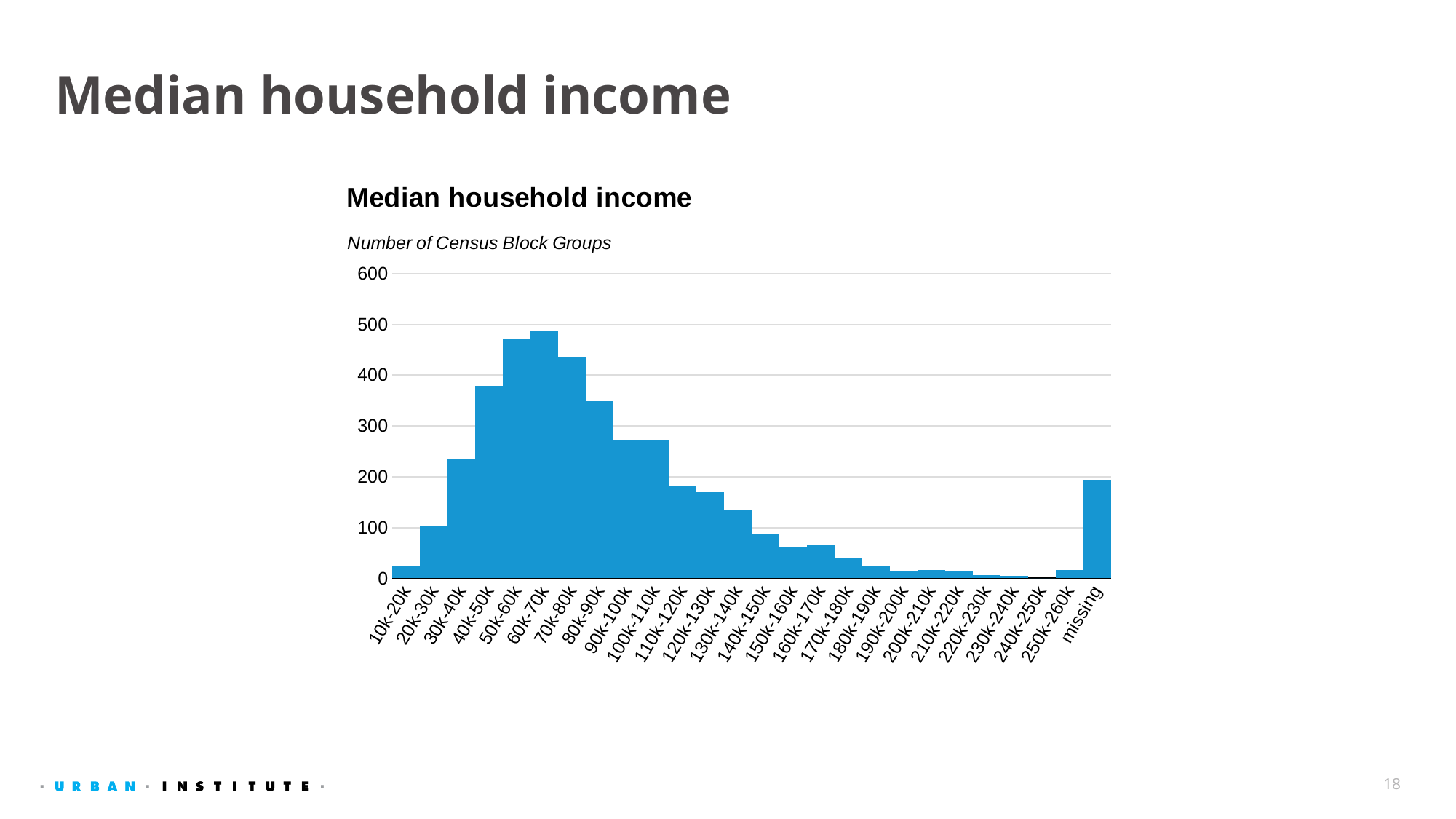
What does the y axis of the chart measure, according to the label above it? Number of Census Block Groups Is the value for 80k-90k greater or less than 300? greater Do the values rise or fall along the x axis from 60k-70k to 190k-200k? fall How many categories are shown along the x axis of the chart? 26 What kind of chart is shown on the slide? bar chart Is the value for 10k-20k greater or less than 100? less Is the value for missing greater or less than 100? greater Which income category has the highest number of census block groups? 60k-70k Which is larger, the value for 50k-60k or the value for 80k-90k? 50k-60k Which is larger, the value for 20k-30k or the value for missing? missing